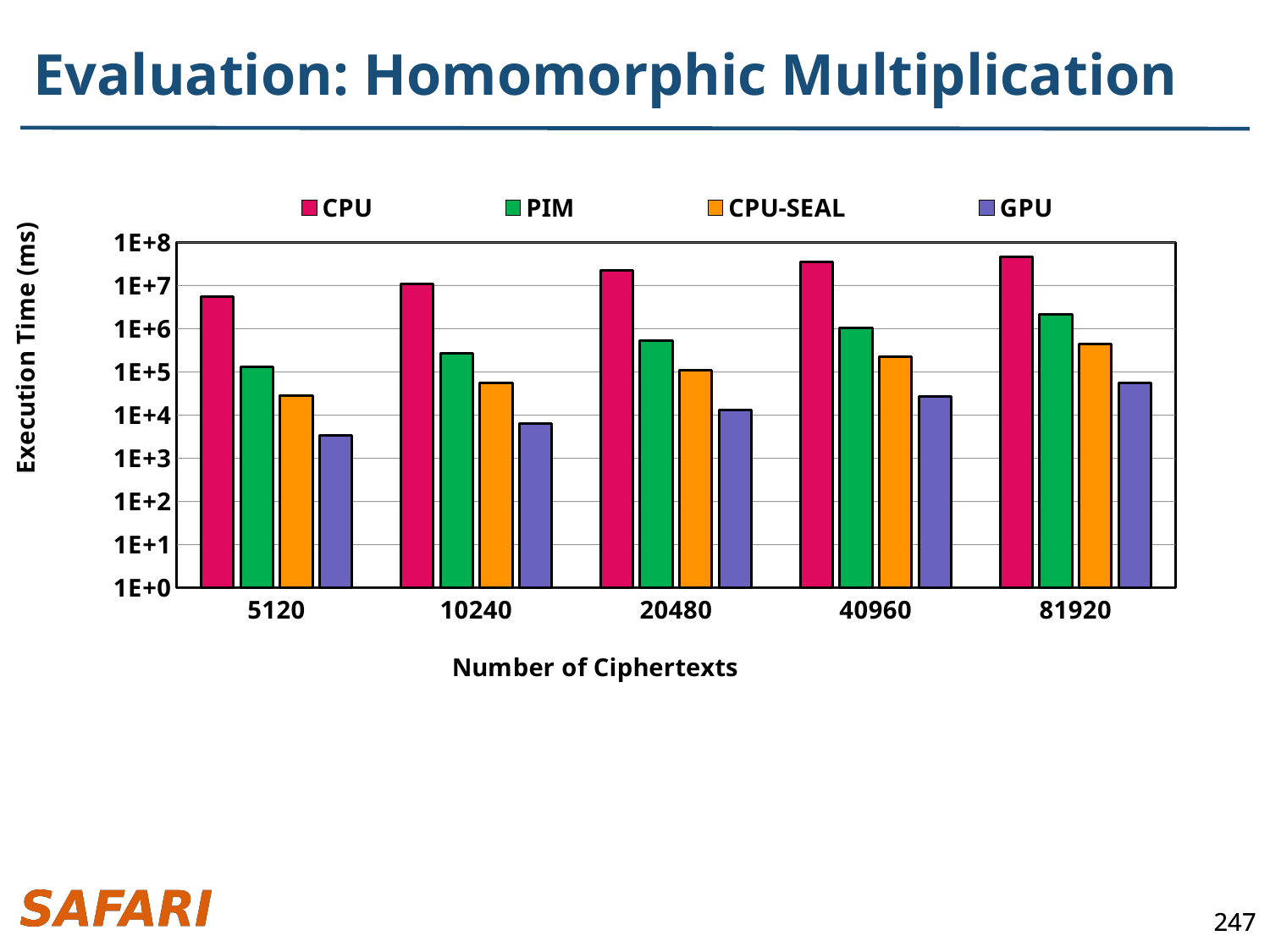
Which series has the lowest execution time at 5120 ciphertexts? GPU Is the CPU execution time at 5120 ciphertexts greater or less than 1E+6? greater How many series does the legend list? 4 What is the label of the y axis? Execution Time (ms) Is the CPU execution time at 81920 ciphertexts greater or less than 1E+7? greater Which series has the highest execution time at 20480 ciphertexts? CPU Do the CPU execution times rise or fall as the number of ciphertexts increases? rise Which is larger at 40960 ciphertexts, the PIM execution time or the CPU-SEAL execution time? PIM What kind of chart is shown on the slide? bar chart Is the CPU-SEAL execution time at 5120 ciphertexts greater or less than 1E+5? less How many categories (numbers of ciphertexts) are shown on the x axis? 5